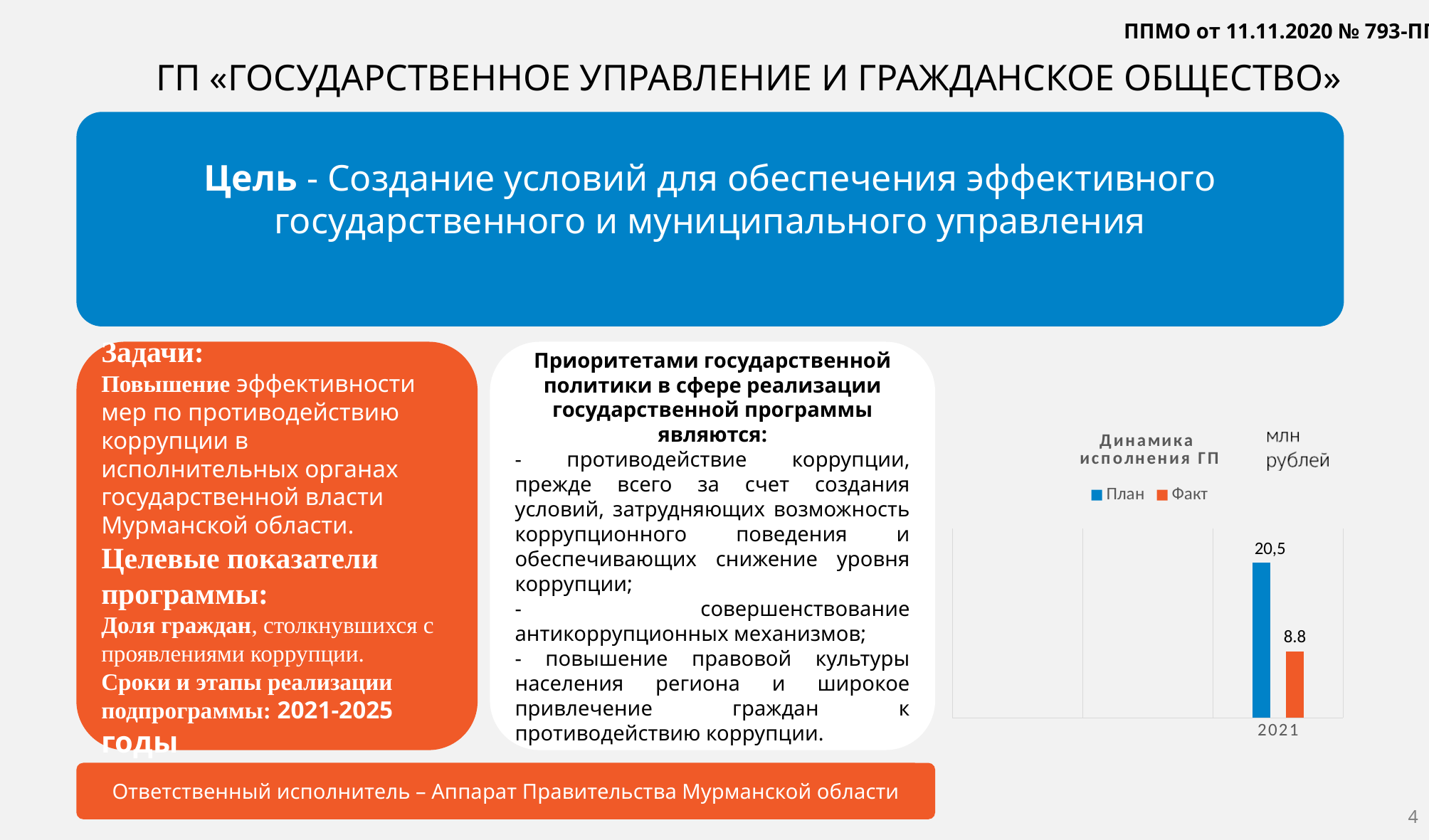
Which series has the larger value for 2021, План or Факт? План How many series does the chart legend list? 2 What is the value of the Факт series for 2021 in the chart? 8.8 What unit is indicated next to the chart? млн рублей What is the title of the chart? Динамика исполнения ГП How many categories are shown on the x axis of the chart? 1 Which year is shown on the x axis of the chart? 2021 What kind of chart is shown on the slide? bar chart What is the value of the План series for 2021 in the chart? 20,5